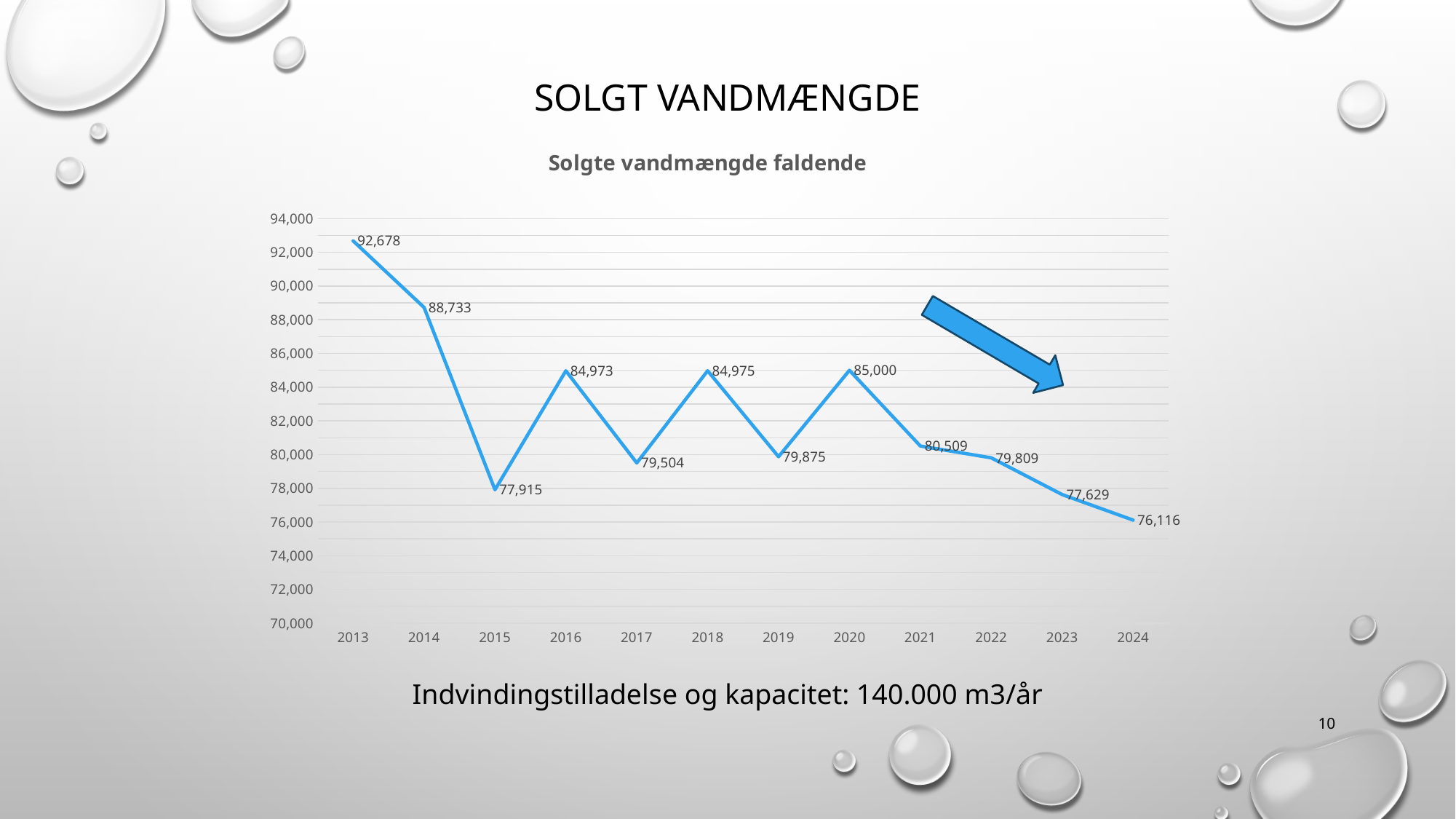
What kind of chart is shown? line chart What was the sold water volume in 2013? 92,678 What is the difference between the 2013 value and the 2024 value? 16,562 What value is shown for 2024? 76,116 Which year has the lowest value? 2024 What value is shown for 2020? 85,000 What value is shown for 2015? 77,915 What is the difference between the 2014 value and the 2015 value? 10,818 Is the value for 2022 greater or less than 80,000? less Which is larger, the value for 2015 or the value for 2017? 2017 Which year has the highest value? 2013 How many years are plotted on the x axis? 12